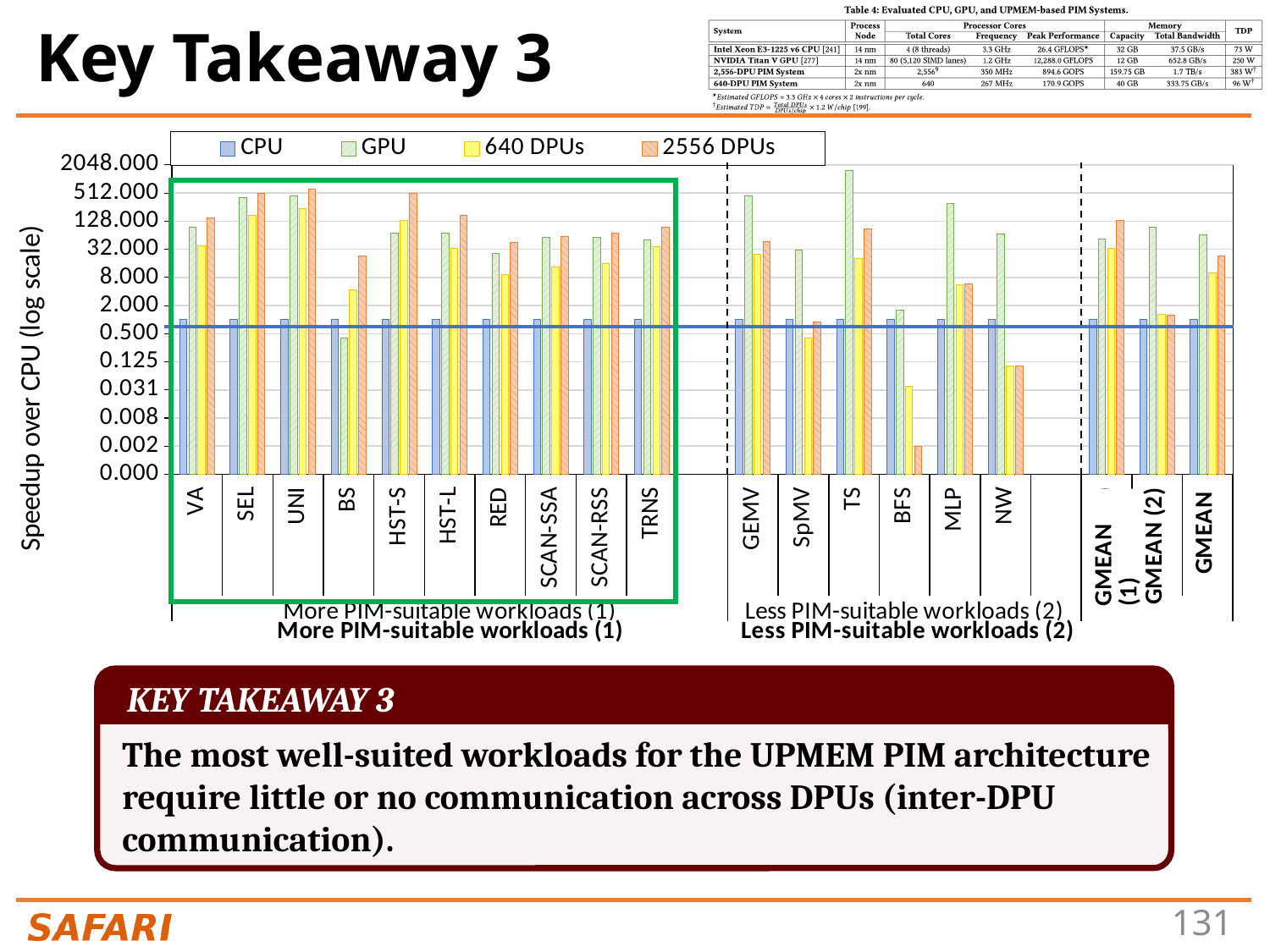
Which workload has the highest GPU bar? TS How many series does the chart legend list? 4 For TS, which is larger: the GPU value or the 2556 DPUs value? GPU For BS, which is larger: the GPU value or the 640 DPUs value? 640 DPUs Is the GPU value for TS greater or less than 512? greater What kind of chart is shown on the slide? bar chart Which series are listed in the chart legend? CPU, GPU, 640 DPUs, 2556 DPUs Is the 2556 DPUs value for BFS greater or less than 0.008? less Is the 640 DPUs value for NW greater or less than 0.5? less What is the label of the y axis of the chart? Speedup over CPU (log scale) How many workload categories are plotted on the x axis, including the GMEAN categories? 19